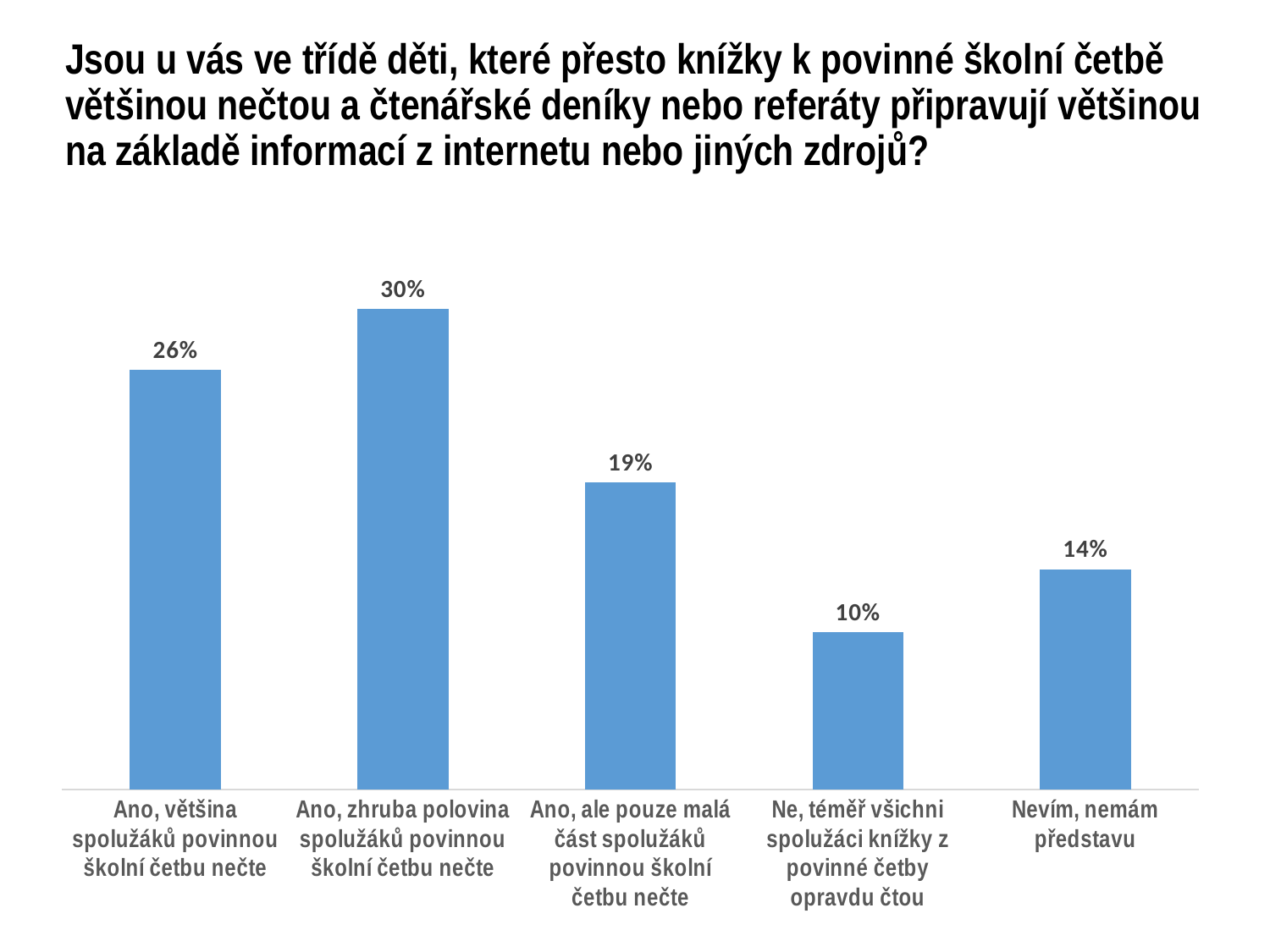
Which category has the lowest value? Ne, téměř všichni spolužáci knížky z povinné četby opravdu čtou What is the value for "Ano, ale pouze malá část spolužáků povinnou školní četbu nečte"? 19% What is the difference between the values for "Ano, zhruba polovina spolužáků povinnou školní četbu nečte" and "Ano, většina spolužáků povinnou školní četbu nečte"? 4% Which category has the highest value? Ano, zhruba polovina spolužáků povinnou školní četbu nečte What is the value for "Ne, téměř všichni spolužáci knížky z povinné četby opravdu čtou"? 10% What is the value for "Nevím, nemám představu"? 14% What is the value for "Ano, zhruba polovina spolužáků povinnou školní četbu nečte"? 30% What is the difference between the values for "Ano, ale pouze malá část spolužáků povinnou školní četbu nečte" and "Nevím, nemám představu"? 5% How many categories are shown in the chart? 5 Which is larger: the value for "Nevím, nemám představu" or the value for "Ne, téměř všichni spolužáci knížky z povinné četby opravdu čtou"? Nevím, nemám představu What is the value for "Ano, většina spolužáků povinnou školní četbu nečte"? 26% What kind of chart is shown on the slide? Bar chart